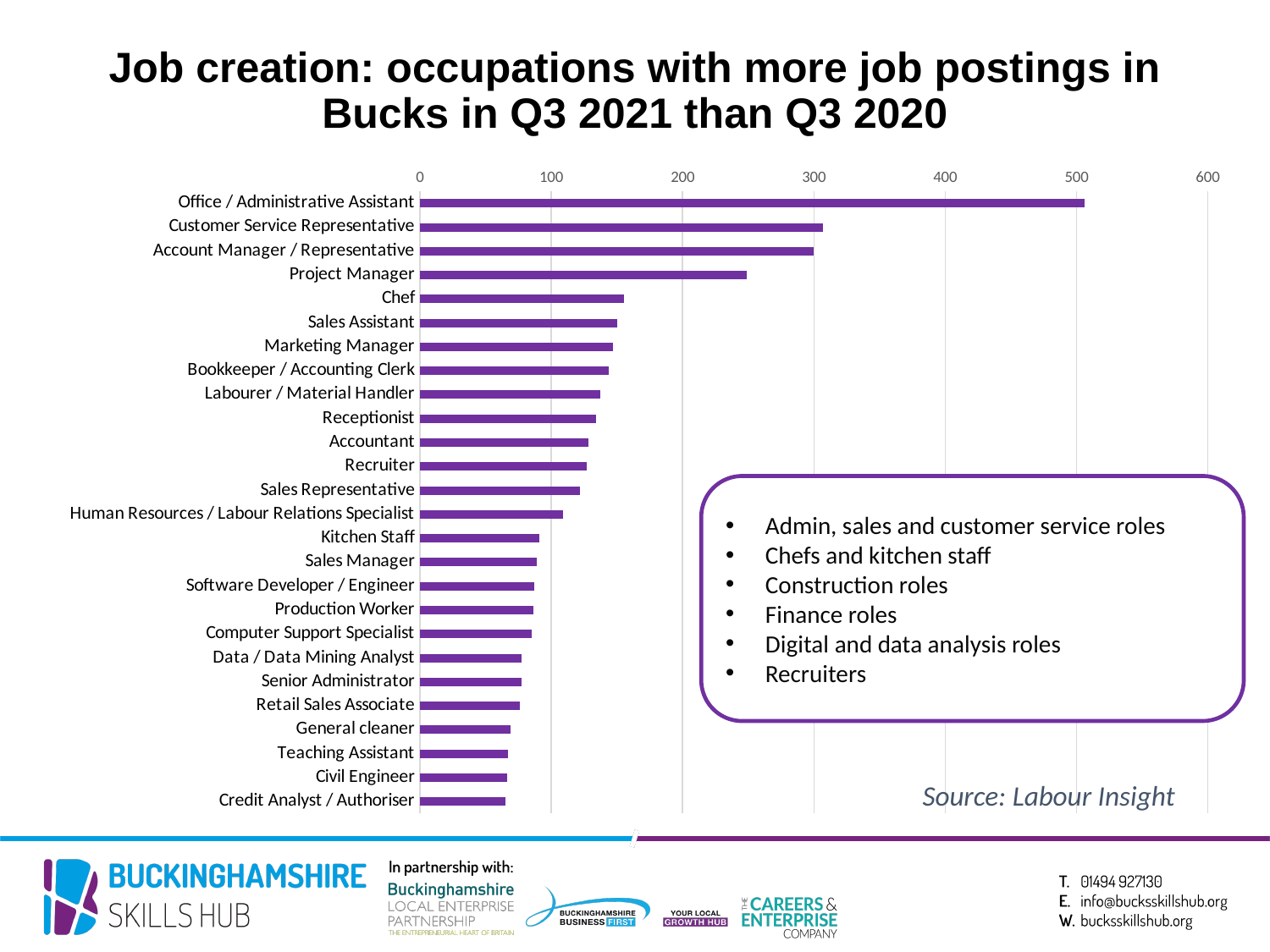
Is the value for Office / Administrative Assistant greater or less than 400? greater Do the bar values rise or fall going from the top of the chart to the bottom? fall How many occupations are listed in the chart? 26 Is the value for Customer Service Representative greater or less than 200? greater Which has a larger value, Project Manager or Chef? Project Manager Is the value for Teaching Assistant greater or less than 100? less What source is cited for the chart data? Labour Insight Which has a larger value, Recruiter or Credit Analyst / Authoriser? Recruiter What kind of chart is shown on the slide? bar chart Which occupation has the highest number of job postings in the chart? Office / Administrative Assistant